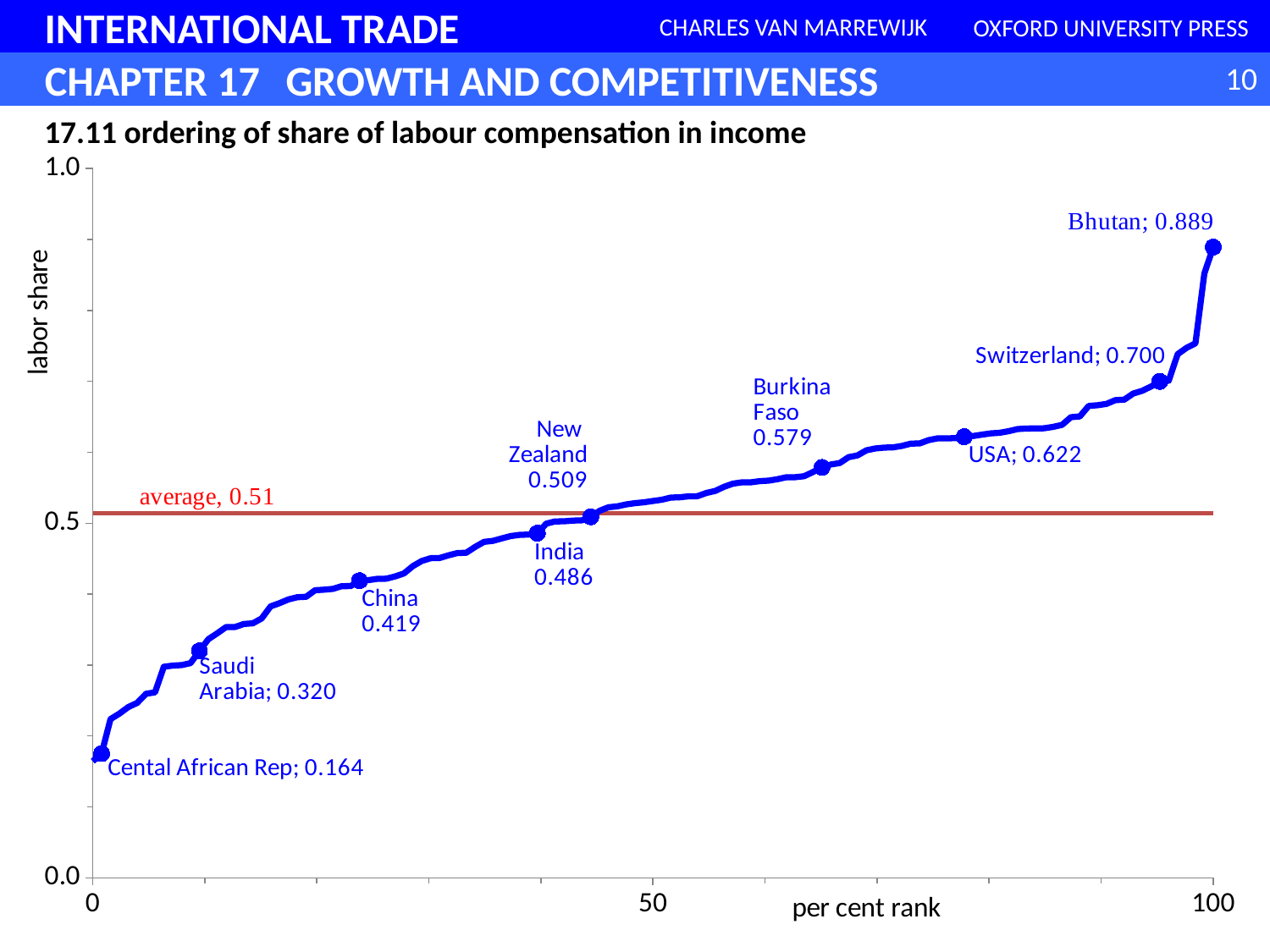
What is the labor share value labelled for China? 0.419 Which labelled country has the highest labor share? Bhutan What average value is marked by the red horizontal line? 0.51 Which has a higher labor share, India or New Zealand? New Zealand Do the labor share values rise or fall as per cent rank increases along the x axis? rise What is the difference between the labor share of Switzerland and the USA? 0.078 What kind of chart is shown on the slide? line chart Is the labor share for Burkina Faso greater or less than 0.5? greater Which labelled country has the lowest labor share? Cental African Rep What is the labor share value labelled for Bhutan? 0.889 What is the labor share value labelled for Saudi Arabia? 0.320 What is the labor share value labelled for the USA? 0.622